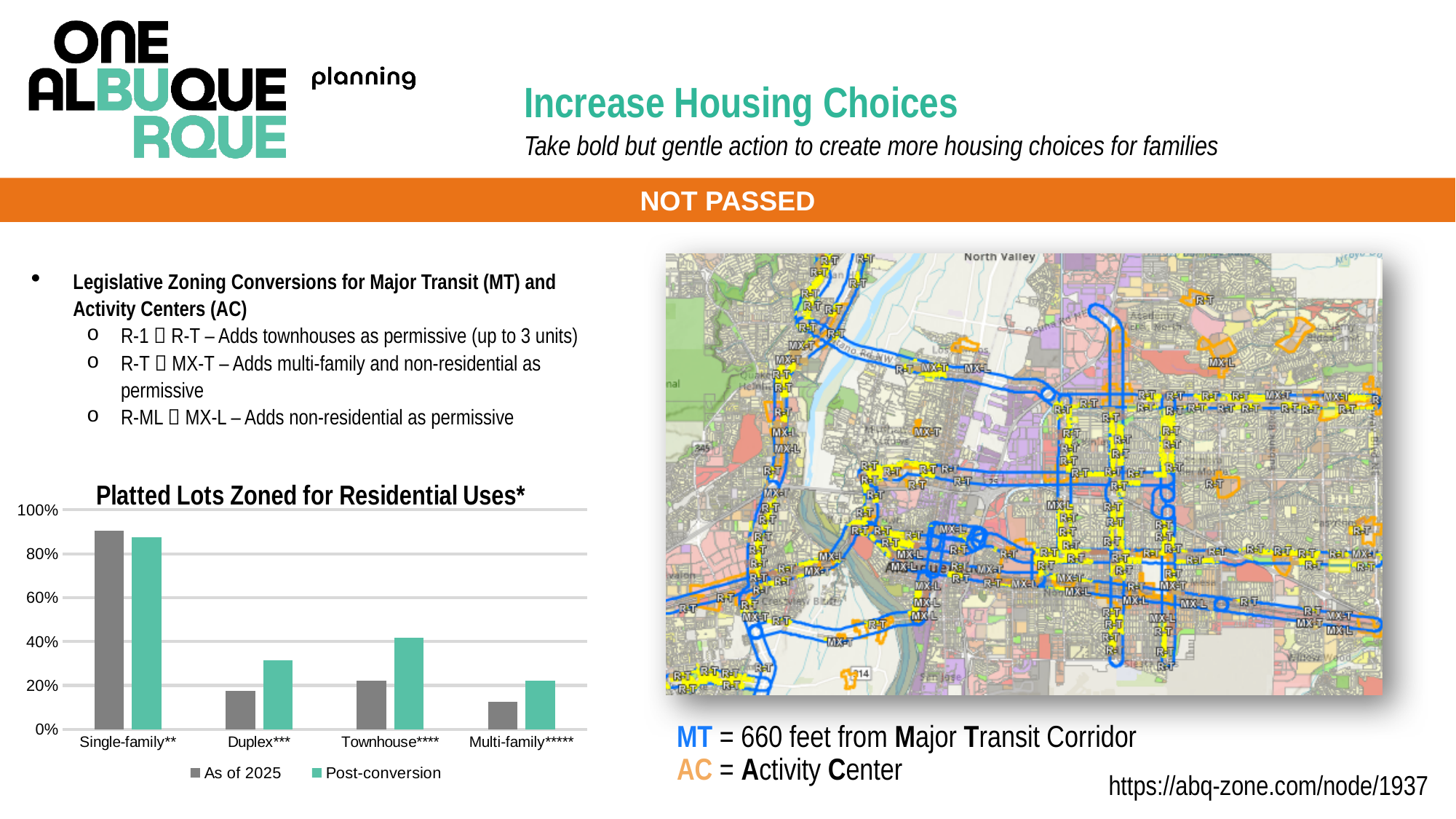
In the "Platted Lots Zoned for Residential Uses*" chart, which is larger for Townhouse****: the "As of 2025" value or the "Post-conversion" value? Post-conversion How many series does the legend of the "Platted Lots Zoned for Residential Uses*" chart list? 2 In the "Platted Lots Zoned for Residential Uses*" chart, which category has the lowest "Post-conversion" value? Multi-family***** In the "Platted Lots Zoned for Residential Uses*" chart, which category has the lowest "As of 2025" value? Multi-family***** What kind of chart is "Platted Lots Zoned for Residential Uses*"? bar chart In the "Platted Lots Zoned for Residential Uses*" chart, which is larger: the "Post-conversion" value for Duplex*** or the "Post-conversion" value for Townhouse****? Townhouse**** In the "Platted Lots Zoned for Residential Uses*" chart, is the "As of 2025" value for Duplex*** greater or less than 20%? less In the "Platted Lots Zoned for Residential Uses*" chart, which category has the highest "As of 2025" value? Single-family** How many categories are shown on the x axis of the "Platted Lots Zoned for Residential Uses*" chart? 4 In the "Platted Lots Zoned for Residential Uses*" chart, is the "Post-conversion" value for Townhouse**** greater or less than 40%? greater In the "Platted Lots Zoned for Residential Uses*" chart, is the "As of 2025" value for Single-family** greater or less than 80%? greater In the "Platted Lots Zoned for Residential Uses*" chart, which colour represents the "Post-conversion" series? teal (green)